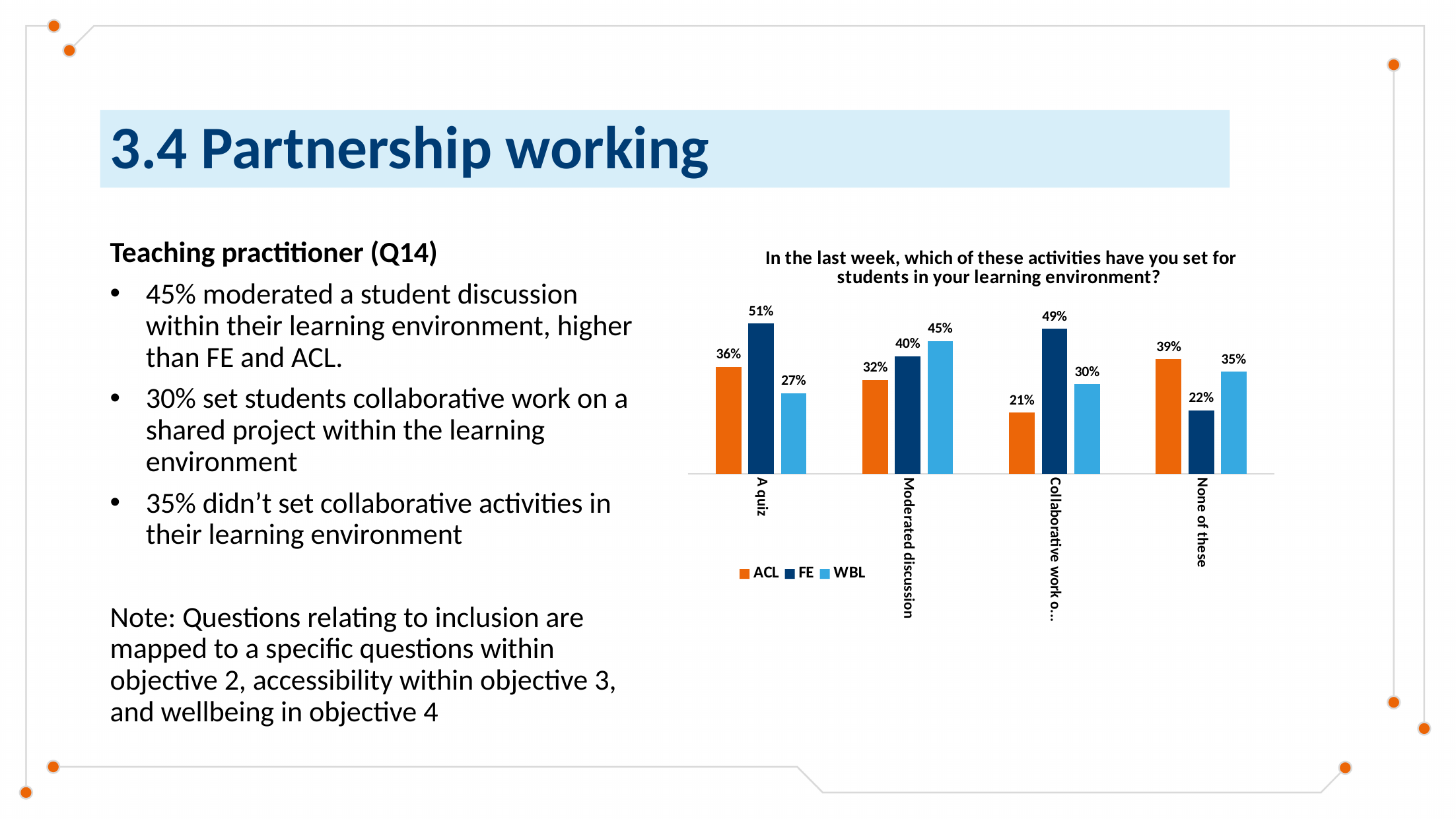
What kind of chart is shown? Bar chart How many categories are shown on the x axis? 4 For 'Moderated discussion', which series has the larger value, ACL or WBL? WBL For 'None of these', which series has the larger value, FE or WBL? WBL What is the difference between the FE and WBL values for 'A quiz'? 24% What is the value for FE for 'A quiz'? 51% How many series does the legend list? 3 Which category has the lowest ACL value? Collaborative work o... What is the title of the chart? In the last week, which of these activities have you set for students in your learning environment? What is the value for ACL for 'None of these'? 39% Which category has the highest FE value? A quiz What is the value for WBL for 'Moderated discussion'? 45%